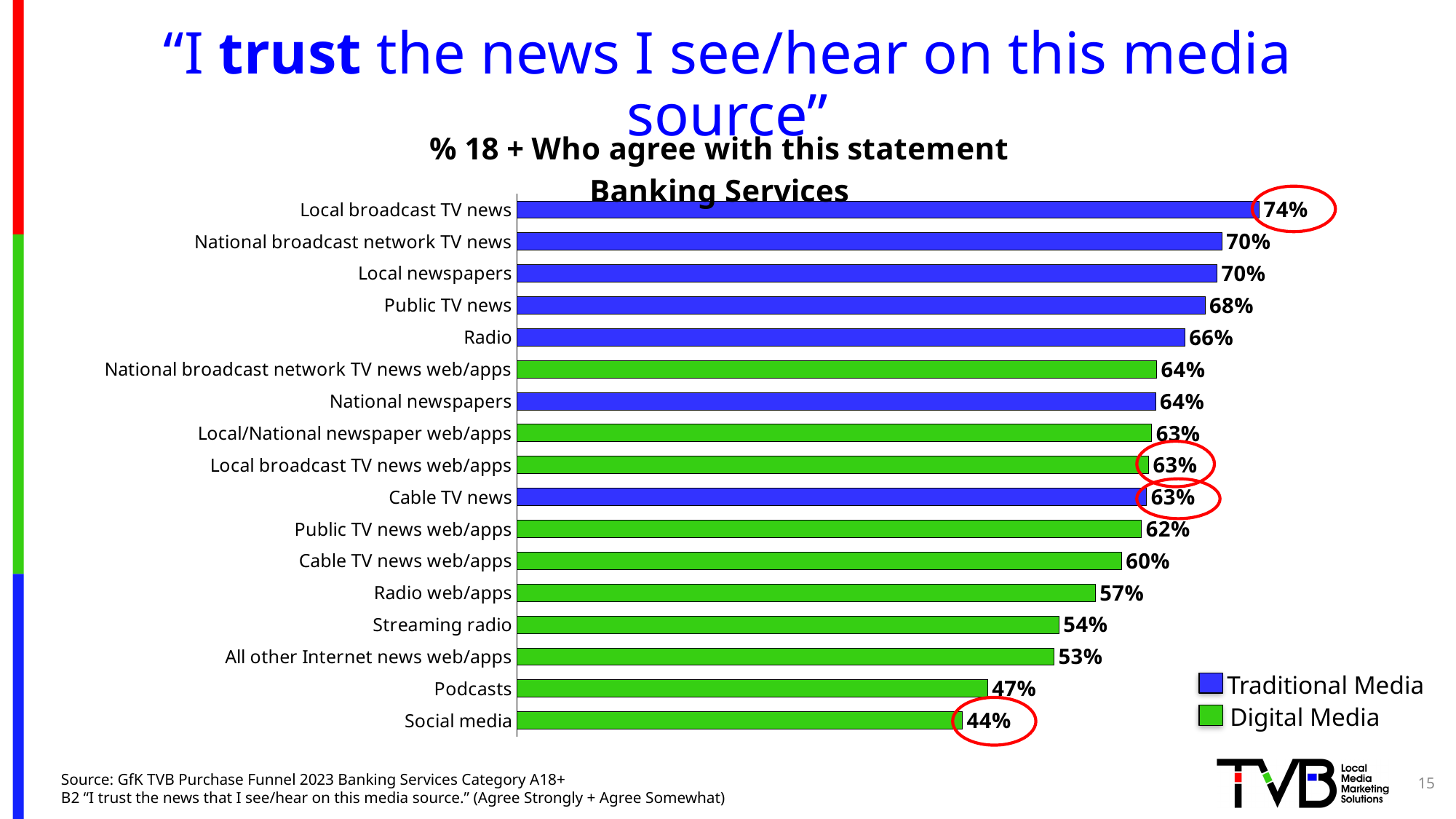
What percentage of adults 18+ agree they trust the news on Local broadcast TV news? 74% What is the value shown for Radio web/apps? 57% What type of chart is shown on the slide? Bar chart What is the difference between the values for Local broadcast TV news and Social media? 30 percentage points Which is larger, the value for Radio or the value for Streaming radio? Radio Which media source has the highest percentage of agreement? Local broadcast TV news How many series does the legend list? 2 What is the difference between the values for Public TV news and Podcasts? 21 percentage points Which media source has the lowest percentage of agreement? Social media What is the value shown for Cable TV news? 63% What is the value shown for Social media? 44% How many media sources are listed in the chart? 17